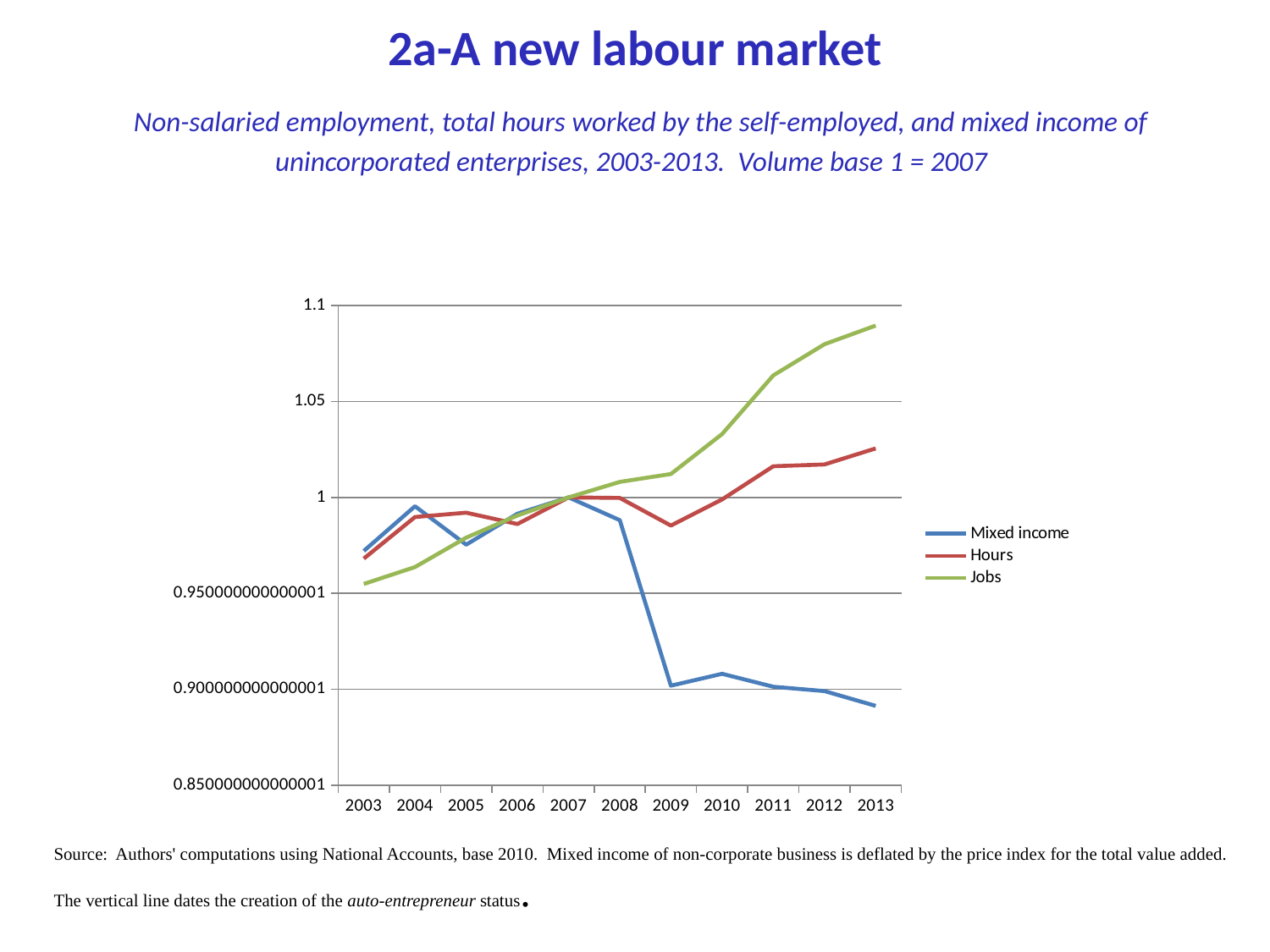
How many years are plotted along the x axis? 11 Is the value for Mixed income in 2013 greater or less than 0.9? less Is the value for Jobs in 2013 greater or less than 1.05? greater Which is larger in 2011, the value for Hours or the value for Jobs? Jobs Does the Jobs series rise or fall from 2003 to 2013? rise Is the value for Hours in 2009 greater or less than 1? less What is the value of all three series in 2007? 1 How many series does the legend list? 3 What kind of chart is shown on the slide? line chart Which series has the lowest value in 2013? Mixed income Which series has the highest value in 2013? Jobs Which series is drawn in green? Jobs